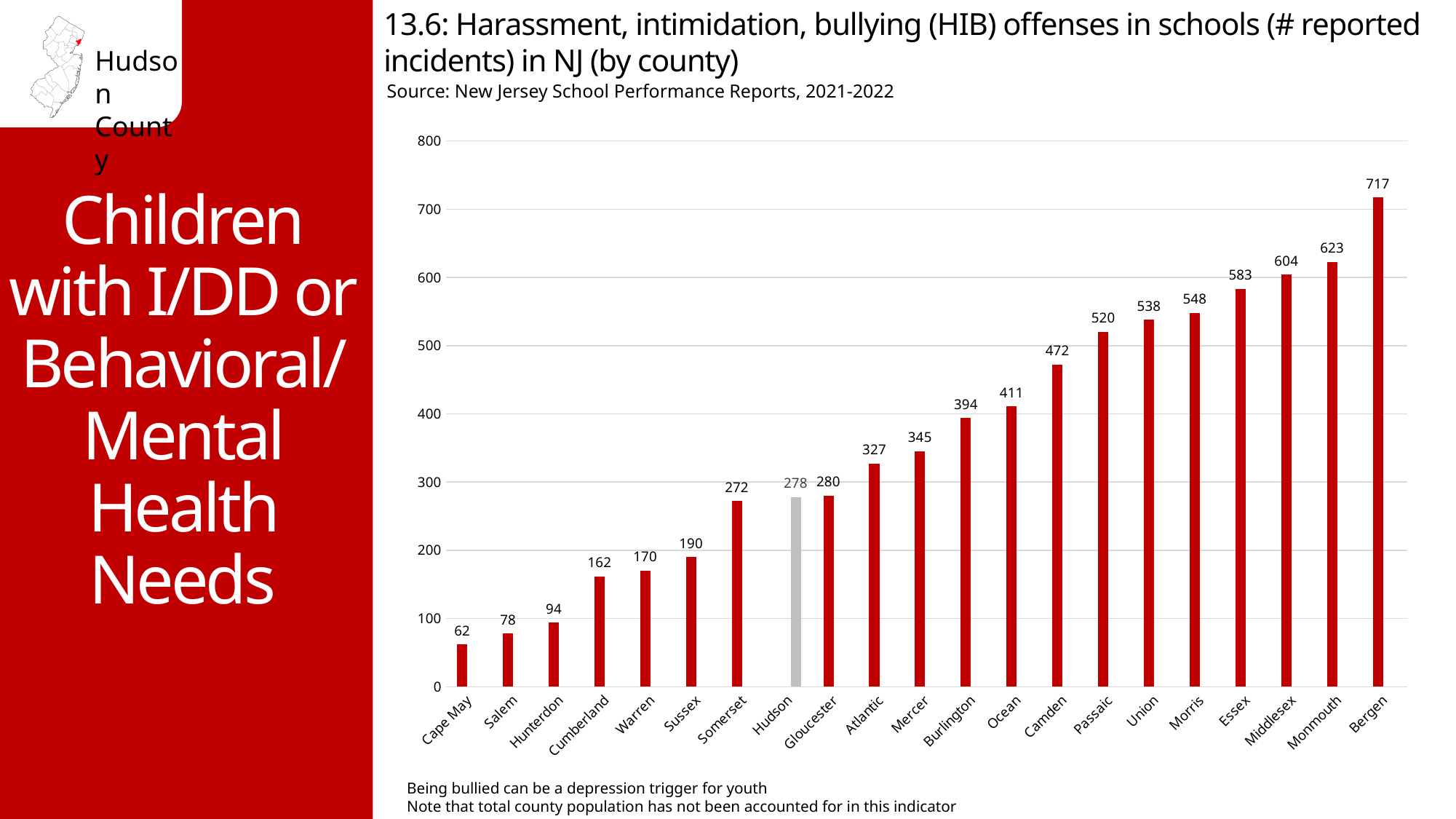
Do the values rise or fall moving from left to right along the x axis? Rise What kind of chart is shown on the slide? Bar chart Which county has the highest number of reported HIB incidents? Bergen How many counties are shown on the x axis of the chart? 21 How many reported HIB incidents does the chart show for Hudson County? 278 What is the value shown for Bergen County? 717 Which county's bar is coloured grey instead of red? Hudson Which county has more reported HIB incidents, Passaic or Camden? Passaic Is the value for Monmouth greater or less than 600? greater What is the value shown for Gloucester County? 280 Which county has the lowest number of reported HIB incidents? Cape May What is the difference between the values for Bergen and Cape May? 655